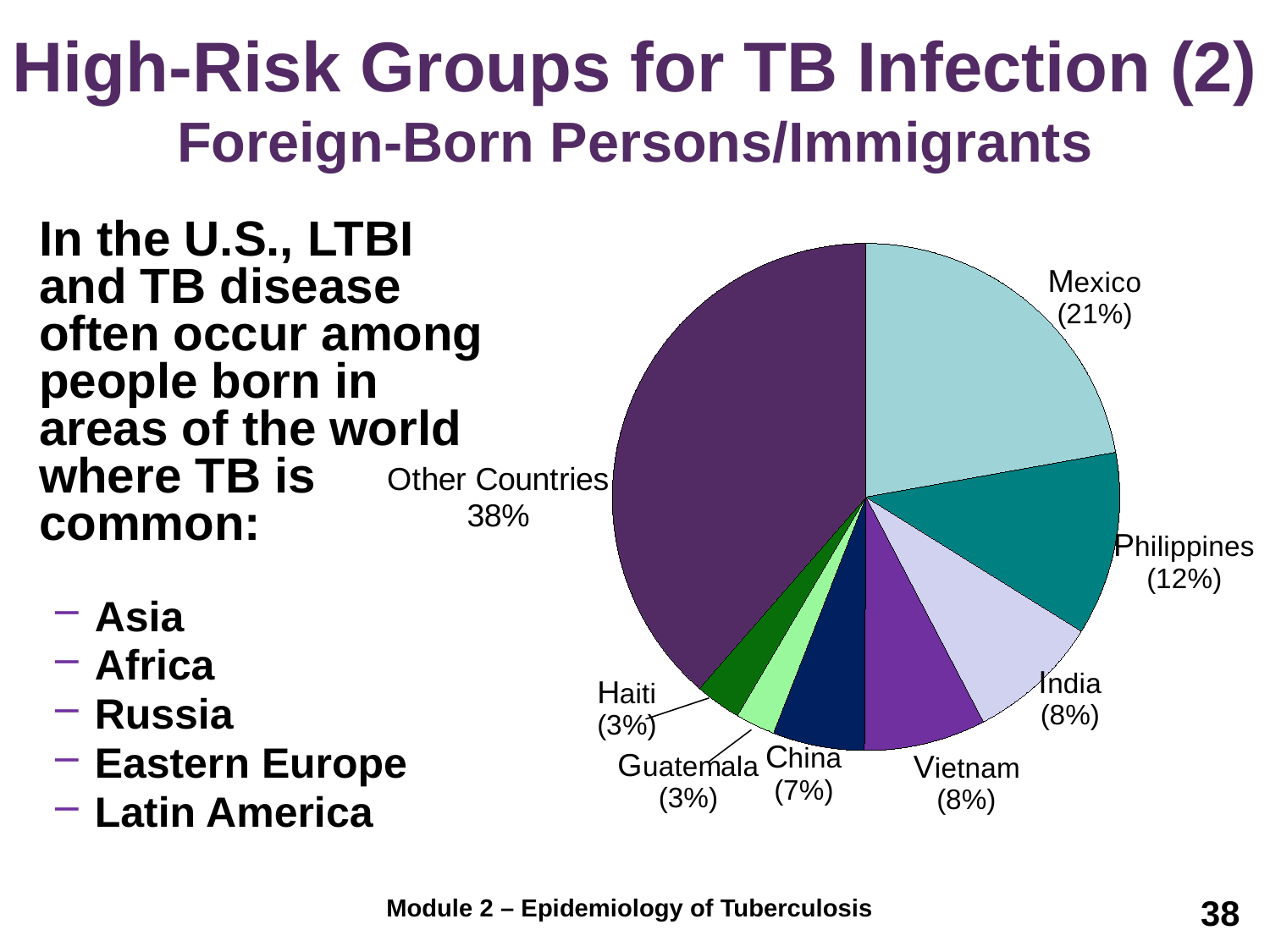
What is the difference in percentage points between Mexico and the Philippines? 9 What percentage is shown for the Philippines? 12% Which has a larger share, Vietnam or China? Vietnam What percentage is shown for China? 7% What percentage is shown for Other Countries? 38% How many slices does the pie chart have? 8 What is the combined percentage of India and Vietnam? 16% What kind of chart is shown on the slide? pie chart Which named country has the largest share of the pie? Mexico Which slice of the pie is the largest? Other Countries Which two countries share the smallest percentage on the pie chart? Guatemala and Haiti What share of the pie does Mexico account for? 21%